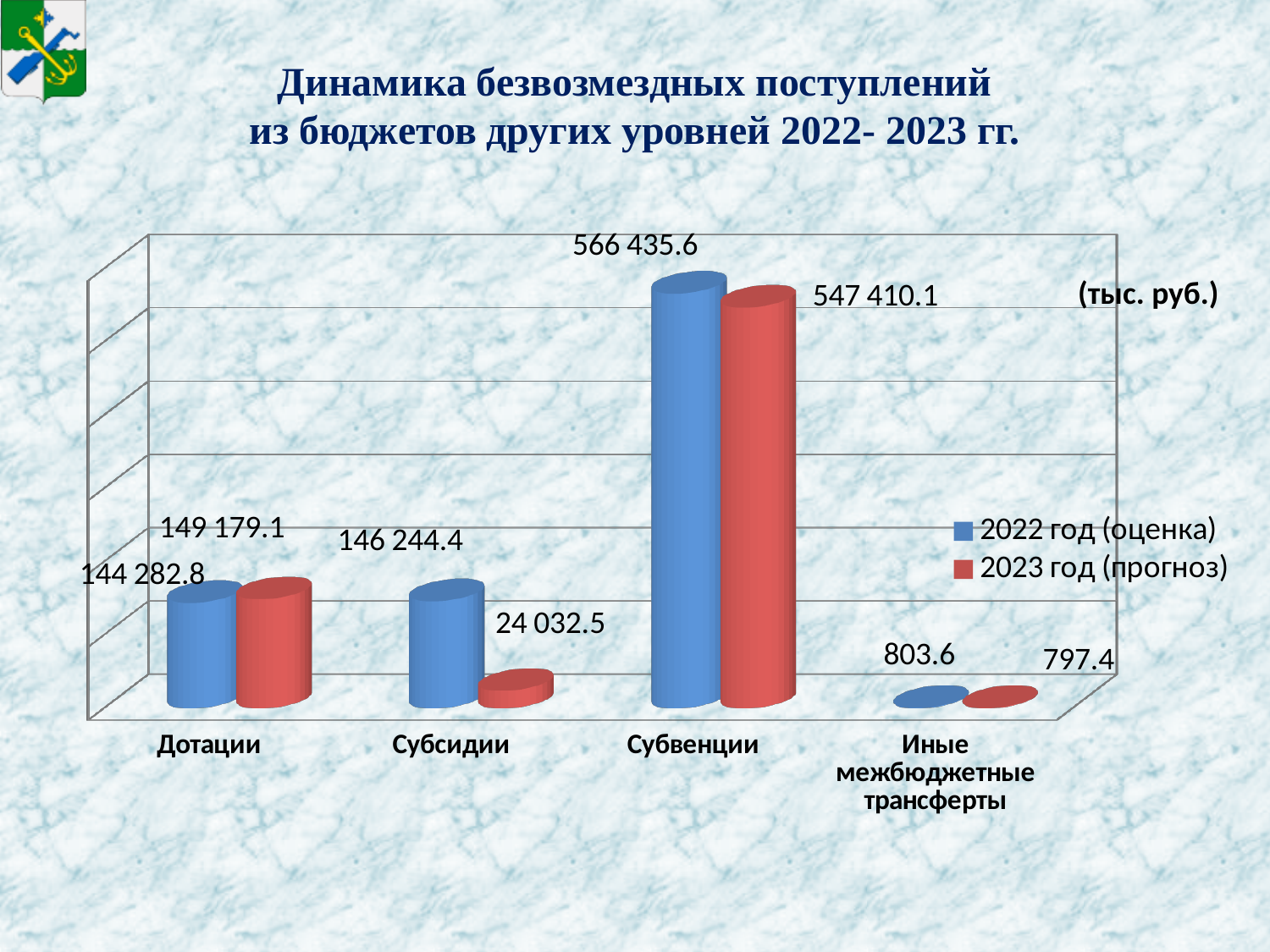
What is the difference between the 2022 год (оценка) and 2023 год (прогноз) values for Субвенции? 19 025.5 Which category has the highest value in the 2022 год (оценка) series? Субвенции What kind of chart is shown on the slide? Bar chart How many categories are shown on the x axis? 4 What is the value for Субсидии in the 2023 год (прогноз) series? 24 032.5 What is the difference between the 2022 год (оценка) and 2023 год (прогноз) values for Субсидии? 122 211.9 What is the value for Субвенции in the 2022 год (оценка) series? 566 435.6 What is the value for Дотации in the 2023 год (прогноз) series? 149 179.1 For Дотации, which is larger: the 2022 год (оценка) value or the 2023 год (прогноз) value? 2023 год (прогноз) Which category has the lowest value in the 2023 год (прогноз) series? Иные межбюджетные трансферты What is the value for Иные межбюджетные трансферты in the 2022 год (оценка) series? 803.6 How many series does the legend list? 2